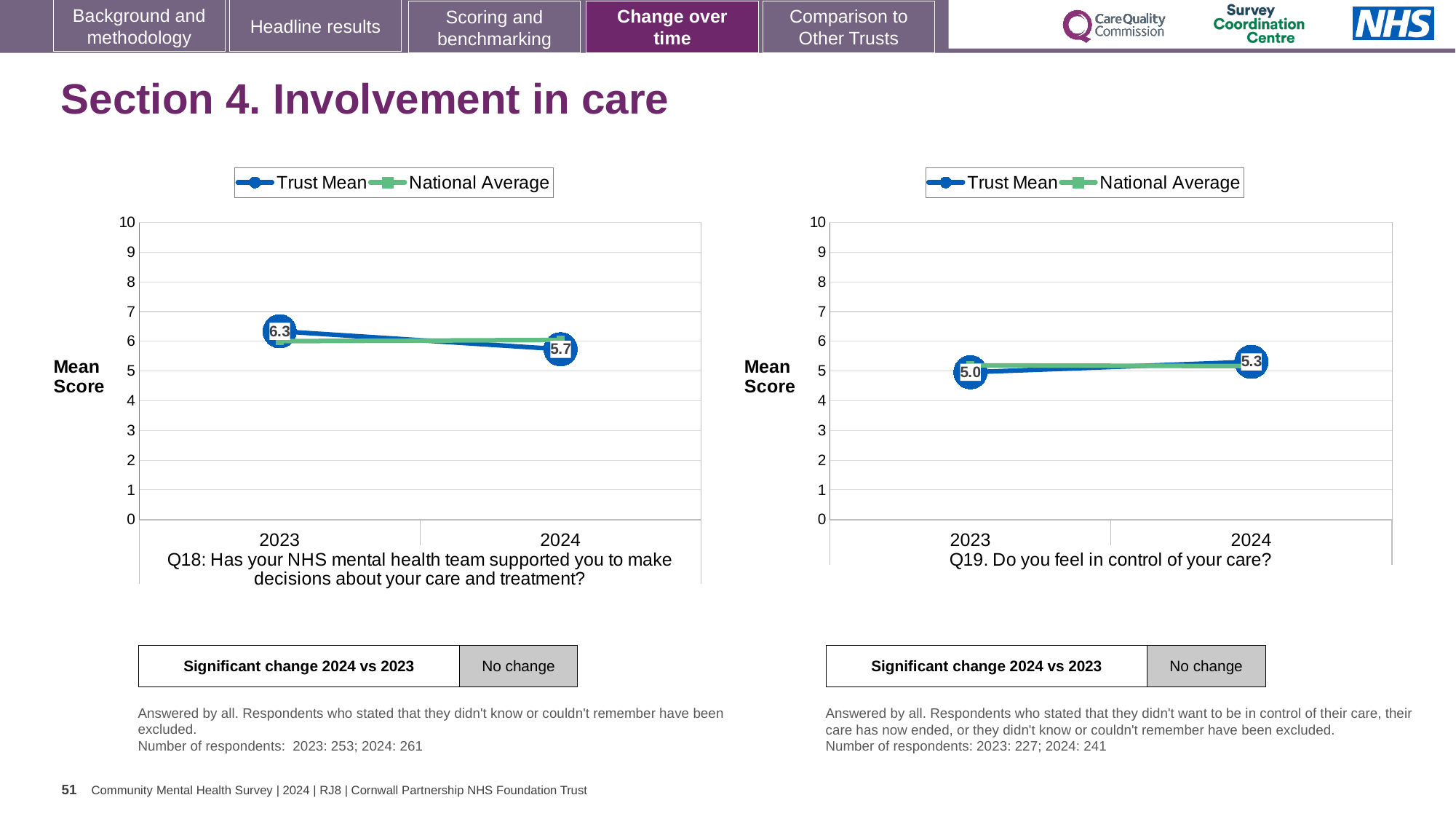
In the Q18 chart on the left, is the National Average for 2023 greater or less than 7? less What kind of chart is the Q18 chart on the left? line chart How many series does the legend of the Q19 chart on the right list? 2 In the Q18 chart on the left, does the Trust Mean rise or fall from 2023 to 2024? fall In the Q18 chart on the left, what is the Trust Mean score for 2023? 6.3 In the Q19 chart on the right, does the Trust Mean rise or fall from 2023 to 2024? rise In the Q19 chart on the right, by how much did the Trust Mean change from 2023 to 2024? 0.3 In the Q19 chart on the right, what is the Trust Mean score for 2024? 5.3 In the Q18 chart on the left, what is the Trust Mean score for 2024? 5.7 In the Q19 chart on the right, what is the Trust Mean score for 2023? 5.0 In the Q19 chart on the right, which is larger in 2023: the Trust Mean or the National Average? National Average In the Q18 chart on the left, by how much did the Trust Mean change from 2023 to 2024? 0.6